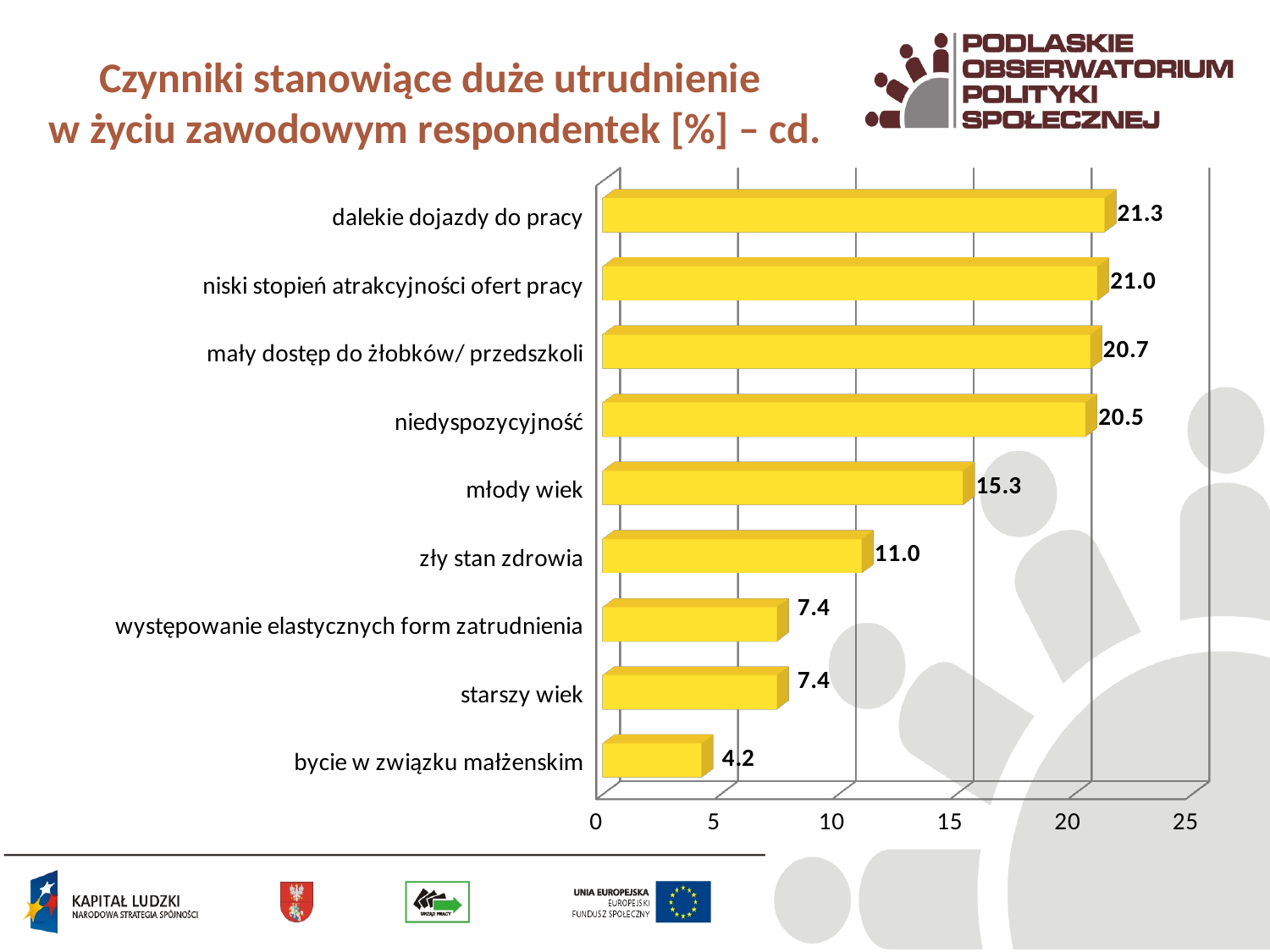
What is the value for "zły stan zdrowia"? 11.0 What kind of chart is shown on the slide? bar chart How many categories are shown in the chart? 9 What is the difference between the values for "młody wiek" and "zły stan zdrowia"? 4.3 Which is larger, the value for "niedyspozycyjność" or the value for "młody wiek"? niedyspozycyjność What is the value for "młody wiek"? 15.3 Which category has the lowest value? bycie w związku małżenskim Which category has the highest value? dalekie dojazdy do pracy What is the value for "bycie w związku małżenskim"? 4.2 What is the difference between the values for "dalekie dojazdy do pracy" and "bycie w związku małżenskim"? 17.1 What is the maximum value shown on the horizontal axis? 25 What is the value for "dalekie dojazdy do pracy"? 21.3